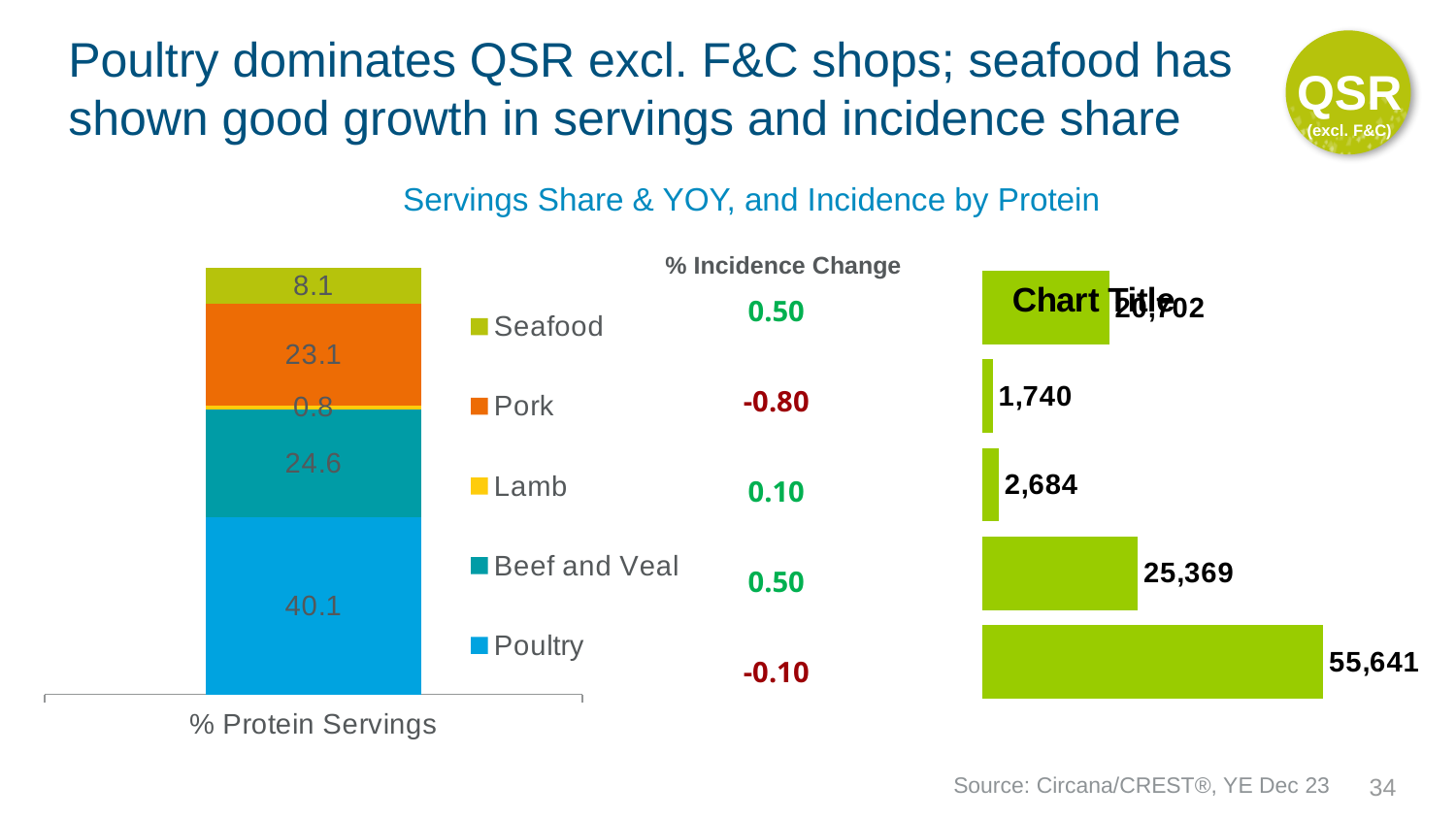
What kind of chart is the chart on the right of the slide? Bar chart In the stacked bar chart on the left (% Protein Servings), what is the value for Pork? 23.1 In the stacked bar chart on the left (% Protein Servings), which is larger, the Beef and Veal value or the Pork value? Beef and Veal In the bar chart on the right, what is the value of the second bar from the bottom? 25,369 In the bar chart on the right, what is the value of the bottom (longest) bar? 55,641 In the bar chart on the right, what is the difference between the bottom bar (55,641) and the bar above it (25,369)? 30,272 In the stacked bar chart on the left (% Protein Servings), what is the value for Seafood? 8.1 In the stacked bar chart on the left (% Protein Servings), which protein has the smallest share? Lamb How many series does the legend of the stacked bar chart on the left list? 5 In the stacked bar chart on the left (% Protein Servings), which protein has the largest share? Poultry In the stacked bar chart on the left (% Protein Servings), what is the value for Poultry? 40.1 In the stacked bar chart on the left (% Protein Servings), what is the difference between the Beef and Veal value and the Pork value? 1.5